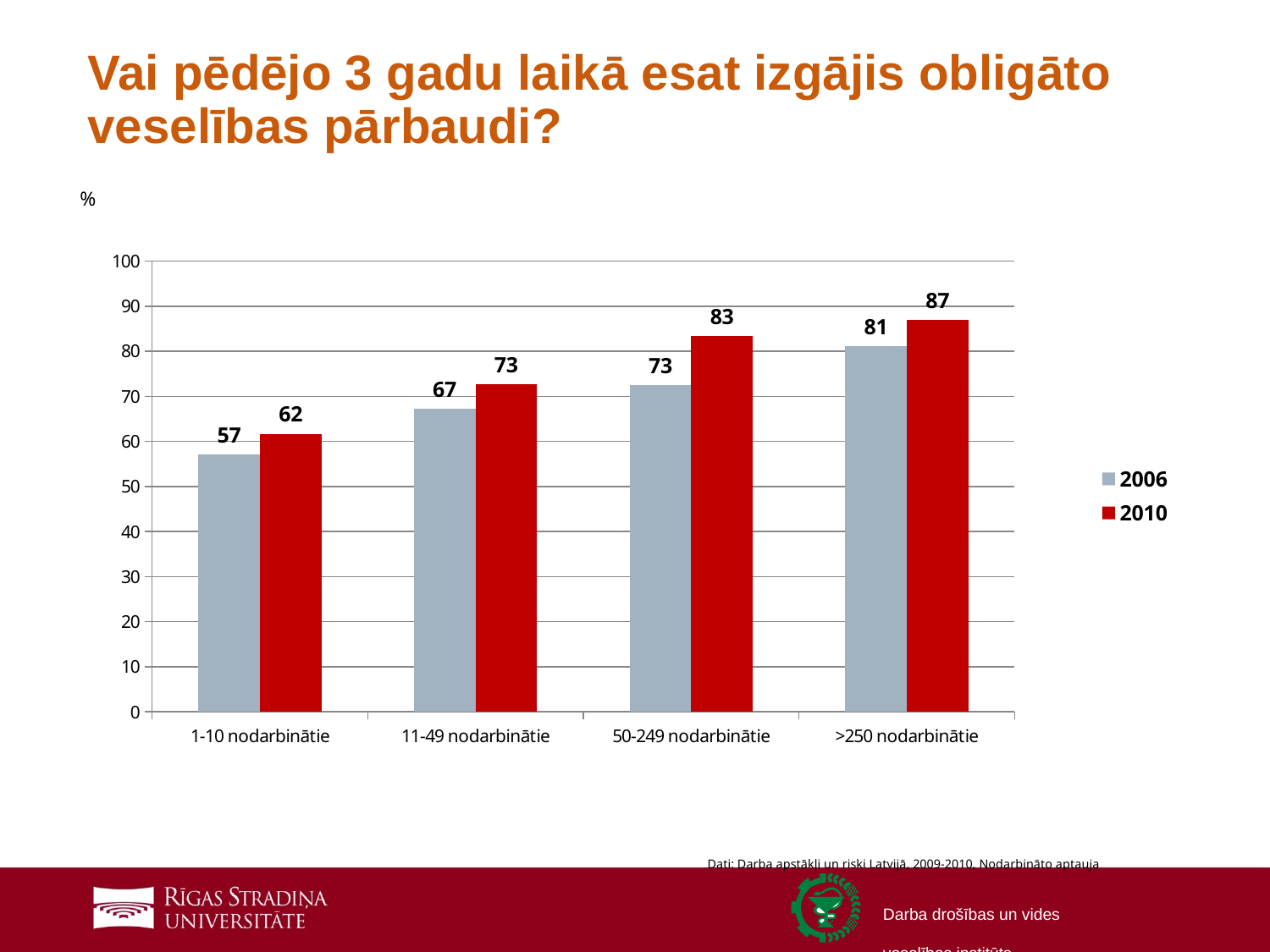
Which category has the highest value for 2010? >250 nodarbinātie What is the difference between the 2010 and 2006 values for 11-49 nodarbinātie? 6 How many categories are shown on the x axis? 4 What kind of chart is shown on the slide? bar chart Is the 2010 value for 1-10 nodarbinātie greater or less than 70? less Which category has the lowest value for 2006? 1-10 nodarbinātie What is the value for 2006 in the >250 nodarbinātie category? 81 What is the value for 2010 in the 1-10 nodarbinātie category? 62 Which is larger: the 2006 value for >250 nodarbinātie or the 2010 value for 50-249 nodarbinātie? 2010 value for 50-249 nodarbinātie Do the 2006 values rise or fall from left to right across the categories? rise How many series does the legend list? 2 What is the value for 2006 in the 50-249 nodarbinātie category? 73